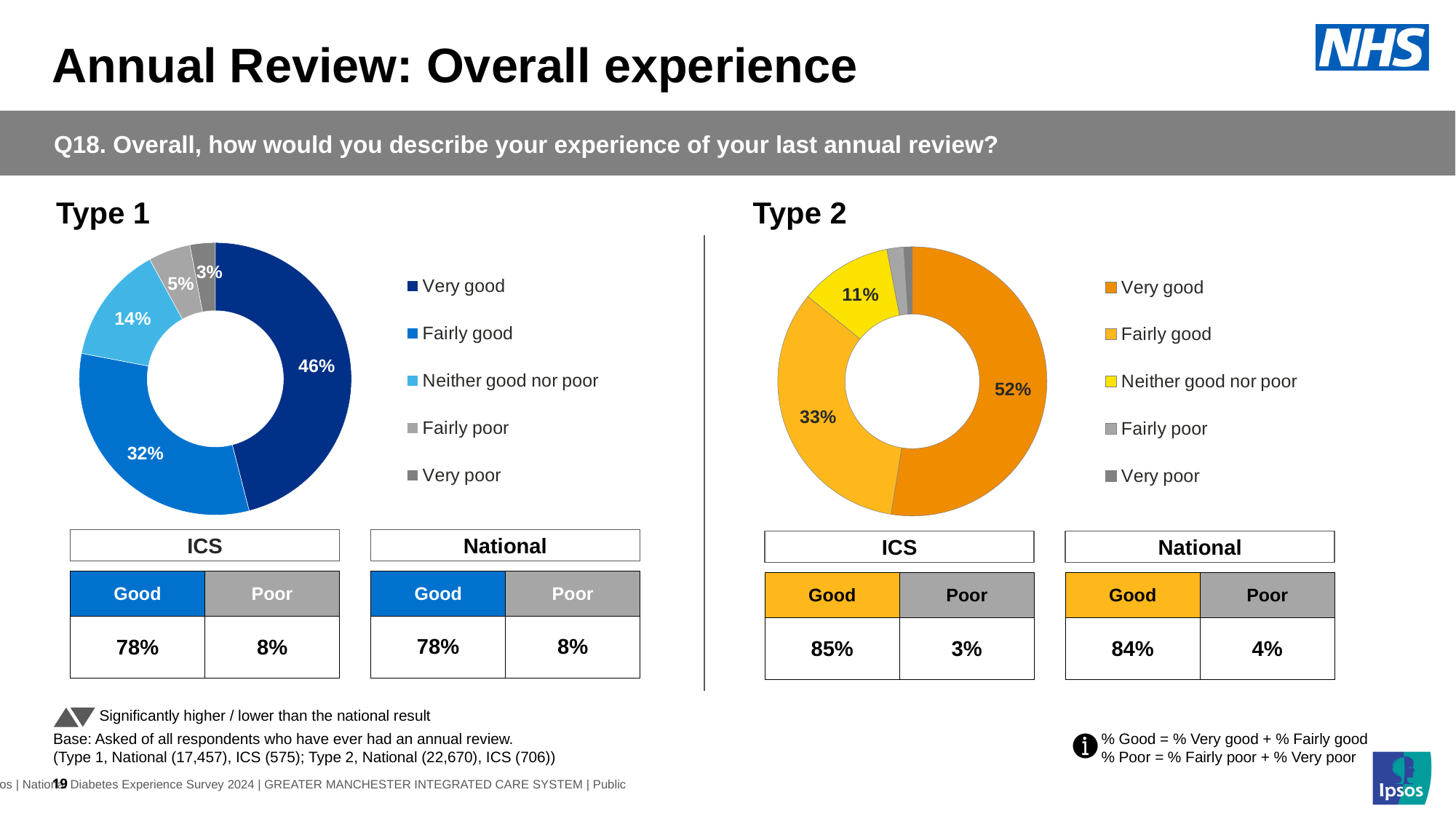
In the Type 2 chart, what percentage said Fairly good? 33% In the Type 1 chart, what percentage said Neither good nor poor? 14% In the Type 1 chart, what percentage of respondents said Fairly good? 32% In the Type 1 chart, what percentage of respondents said their experience was Very good? 46% Which chart has the larger Very good share, Type 1 or Type 2? Type 2 In the Type 2 chart, what percentage said Neither good nor poor? 11% In the Type 1 chart, which response category has the smallest share? Very poor How many response categories does the legend of the Type 2 chart list? 5 In the Type 1 chart, which response category has the largest share? Very good In the Type 2 chart, what percentage of respondents said Very good? 52% In the Type 1 chart, what is the difference between the Very good and Fairly good shares? 14 percentage points In the Type 1 chart, what percentage said Very poor? 3%